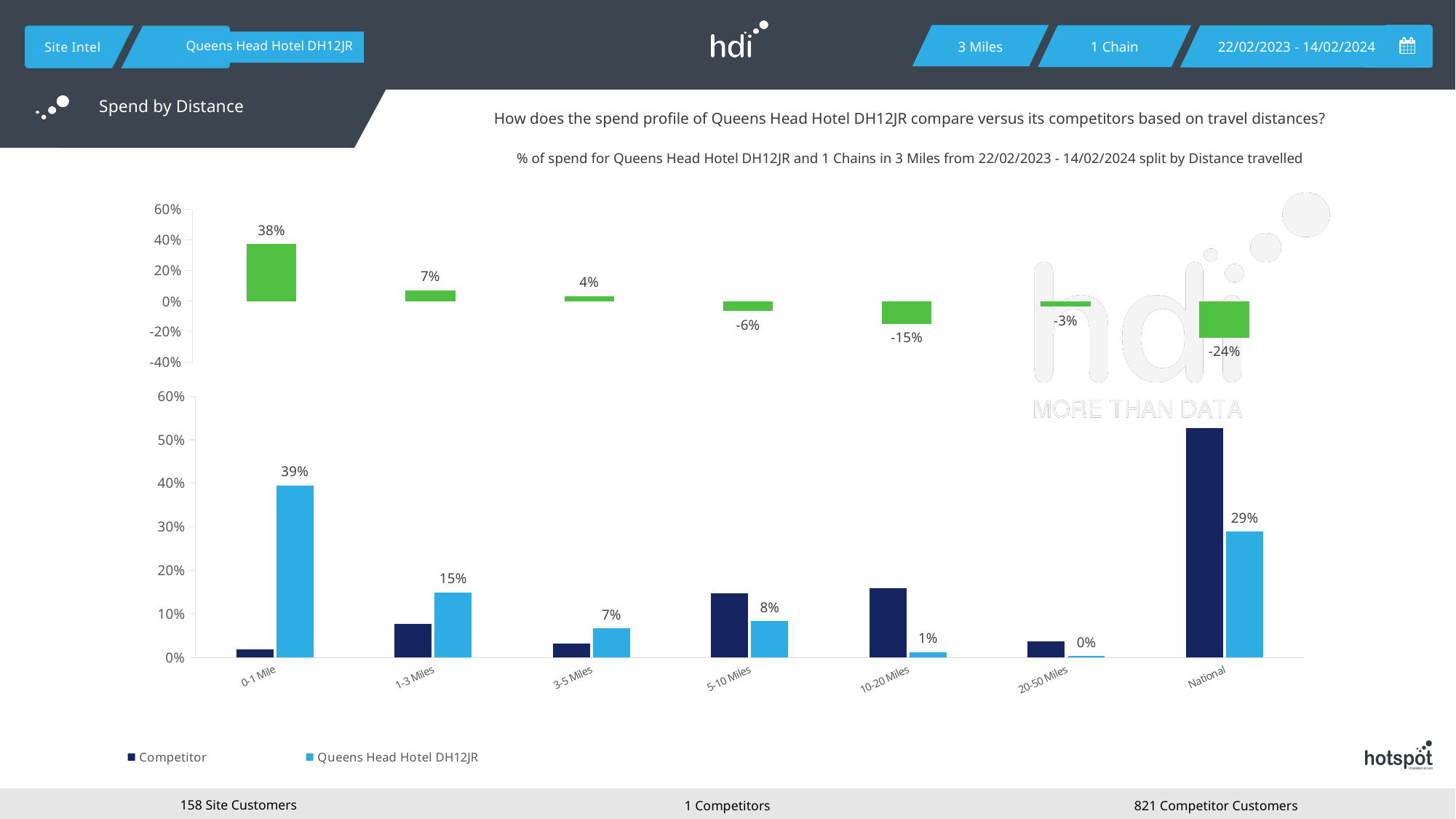
In the bottom chart, what is the value for Queens Head Hotel DH12JR at National? 29% How many distance categories are shown on the x axis of the bottom chart? 7 In the bottom chart, is the Competitor value for 10-20 Miles greater or less than 10%? greater In the bottom chart, which distance band has the lowest value for Queens Head Hotel DH12JR? 20-50 Miles In the top chart, what is the value of the lowest (most negative) bar? -24% How many series does the legend of the bottom chart list? 2 In the bottom chart, what is the difference between the Queens Head Hotel DH12JR values at 0-1 Mile and 1-3 Miles? 24 percentage points In the bottom chart, which distance band has the highest value for Queens Head Hotel DH12JR? 0-1 Mile In the bottom chart, is the Competitor value for National greater or less than 50%? greater In the bottom chart, what is the value for Queens Head Hotel DH12JR at 0-1 Mile? 39% In the bottom chart, at 5-10 Miles, which series has the larger value: Competitor or Queens Head Hotel DH12JR? Competitor What kind of chart is the bottom chart? Bar chart